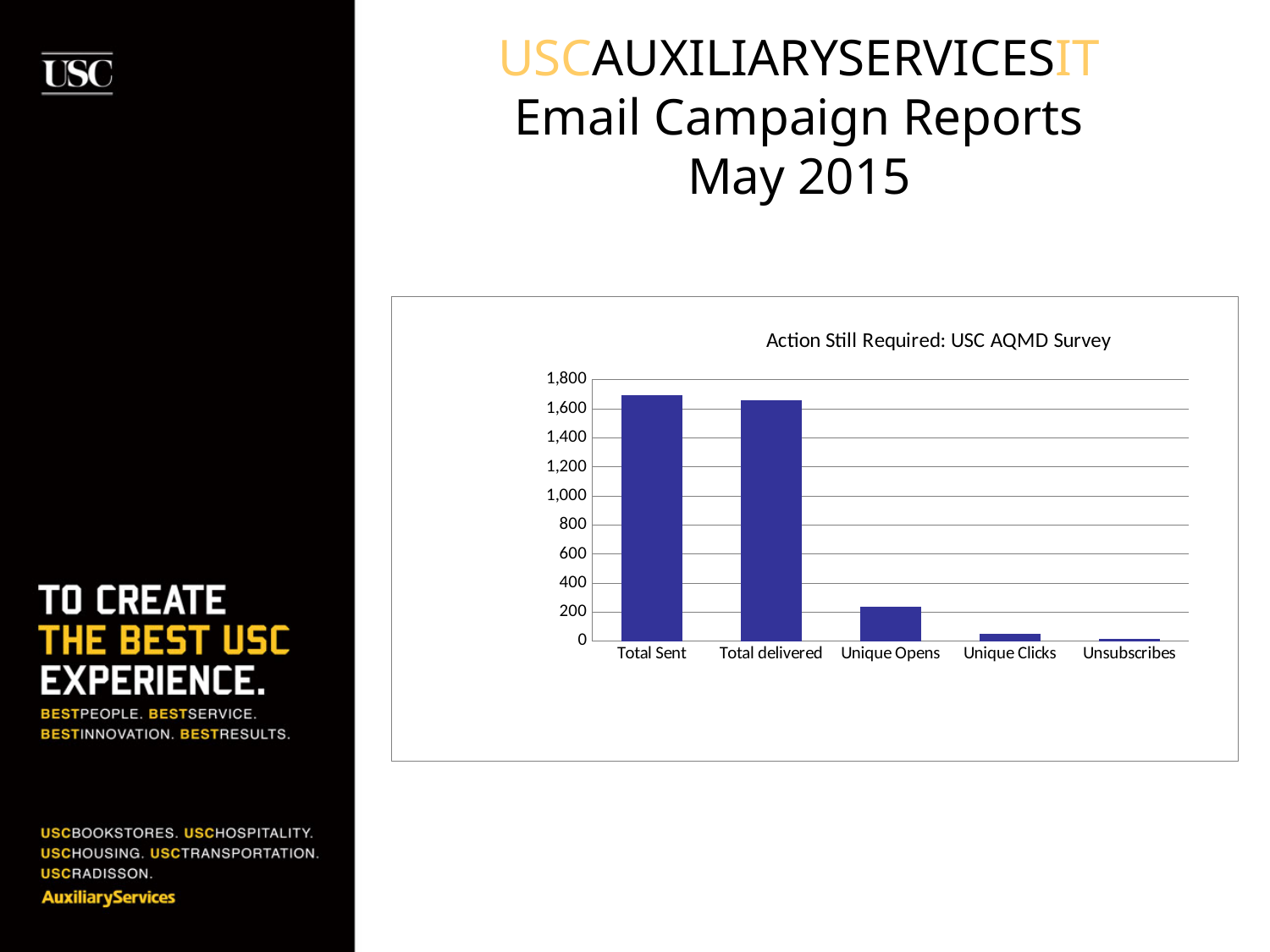
Do the values rise or fall moving from left to right along the x axis? fall Is the value for Total delivered greater or less than 1,400? greater Which is larger, the value for Unique Opens or the value for Unique Clicks? Unique Opens Is the value for Unique Clicks greater or less than 200? less Is the value for Total Sent greater or less than 1,600? greater Which is larger, the value for Total delivered or the value for Unique Opens? Total delivered What kind of chart is shown on the slide? bar chart How many categories are shown on the x axis of the chart? 5 Which category has the highest value in the chart? Total Sent What is the title of the chart? Action Still Required: USC AQMD Survey Which category has the lowest value in the chart? Unsubscribes